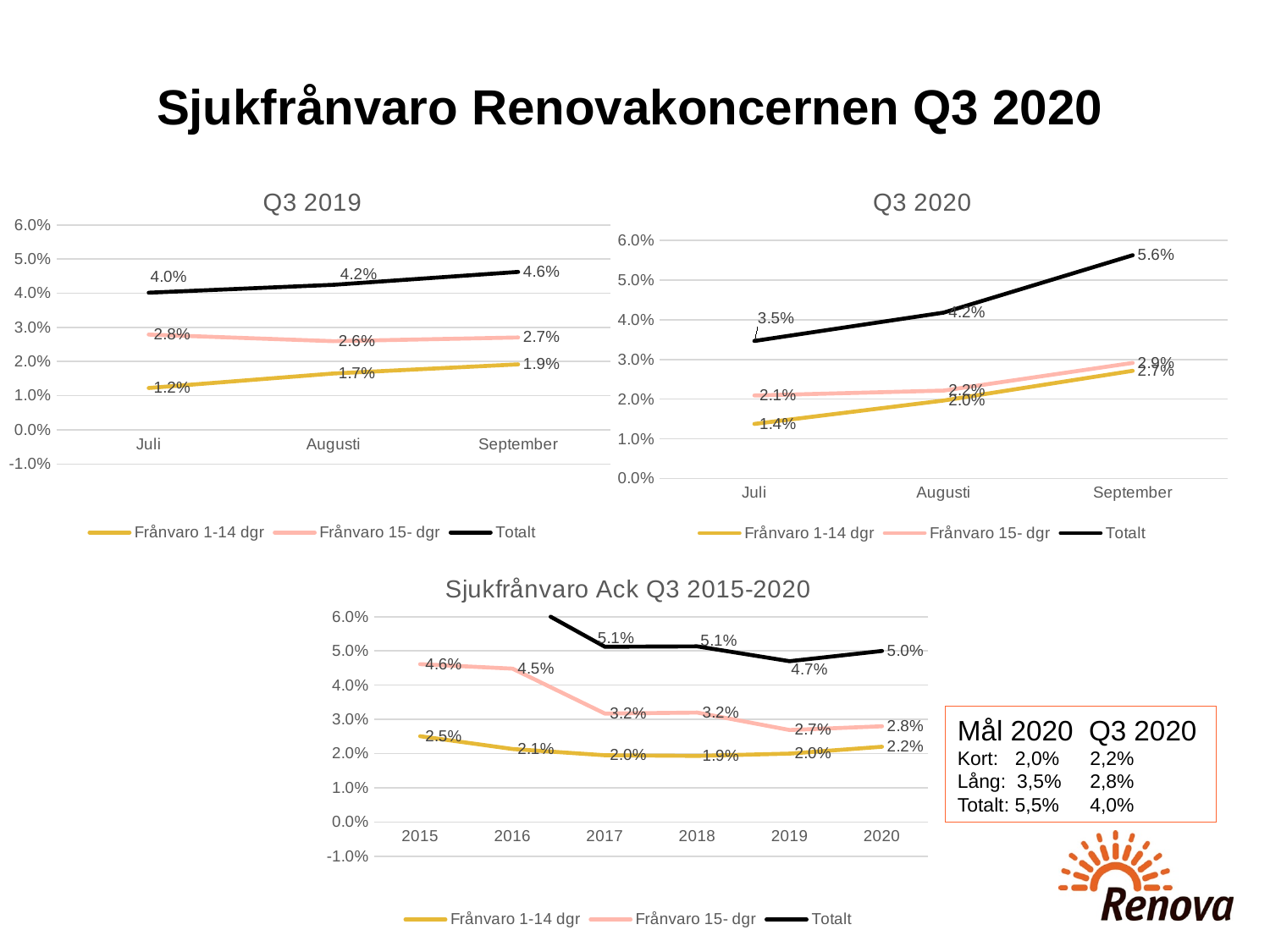
In the Q3 2020 chart, what is the Totalt value for September? 5.6% In the Q3 2020 chart, does the Totalt line rise or fall from Juli to September? Rises How many series does the legend of the Q3 2020 chart list? 3 In the Sjukfrånvaro Ack Q3 2015-2020 chart, which year has the lowest Frånvaro 1-14 dgr value? 2018 In the Q3 2020 chart, what is the value of Frånvaro 1-14 dgr for Juli? 1.4% In the Q3 2019 chart, by how much does Totalt increase from Juli to September? 0.6 percentage points How many years are shown on the x axis of the Sjukfrånvaro Ack Q3 2015-2020 chart? 6 In the Q3 2019 chart, what is the Totalt value for September? 4.6% What type of chart is the Q3 2019 chart? Line chart In the Q3 2019 chart, is Frånvaro 15- dgr higher in Juli or in Augusti? Juli In the Sjukfrånvaro Ack Q3 2015-2020 chart, what is the Frånvaro 15- dgr value for 2015? 4.6% In the Sjukfrånvaro Ack Q3 2015-2020 chart, what is the Totalt value for 2019? 4.7%